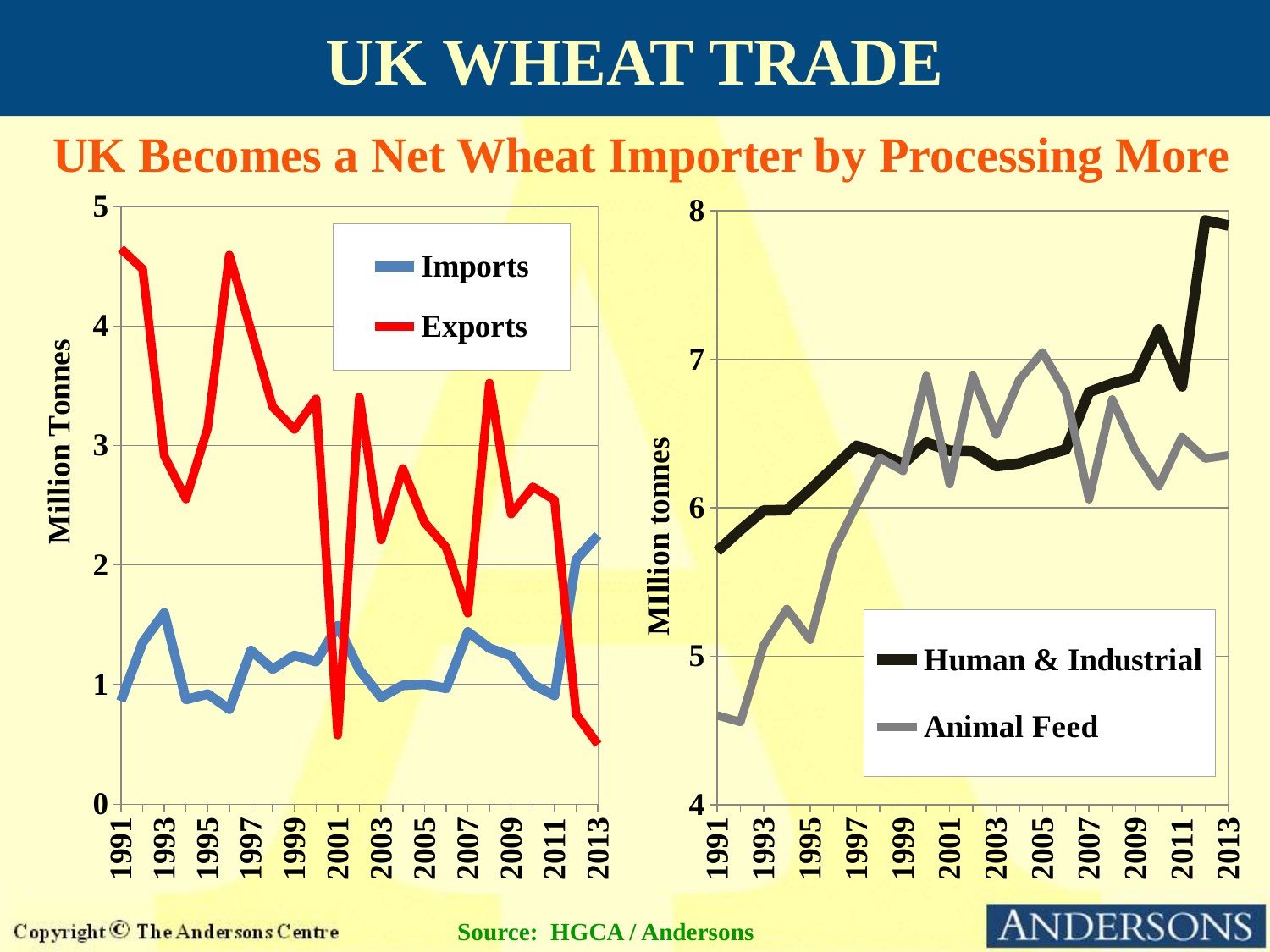
In the left chart (Imports/Exports), is the value for Exports in 1991 greater or less than 4? greater In the right chart (Human & Industrial/Animal Feed), is the value for Animal Feed in 1991 greater or less than 5? less In the left chart (Imports/Exports), which series has the larger value in 1991, Imports or Exports? Exports In the right chart (Human & Industrial/Animal Feed), is the value for Human & Industrial in 2013 greater or less than 7? greater In the left chart (Imports/Exports), which series has the larger value in 2013, Imports or Exports? Imports How many series does the legend of the right chart (Human & Industrial/Animal Feed) list? 2 In the right chart (Human & Industrial/Animal Feed), which series has the larger value in 1991? Human & Industrial How many series does the legend of the left chart (Imports/Exports) list? 2 In the left chart (Imports/Exports), do Exports overall rise or fall from 1991 to 2013? fall What kind of chart is the left chart showing Imports and Exports? line chart